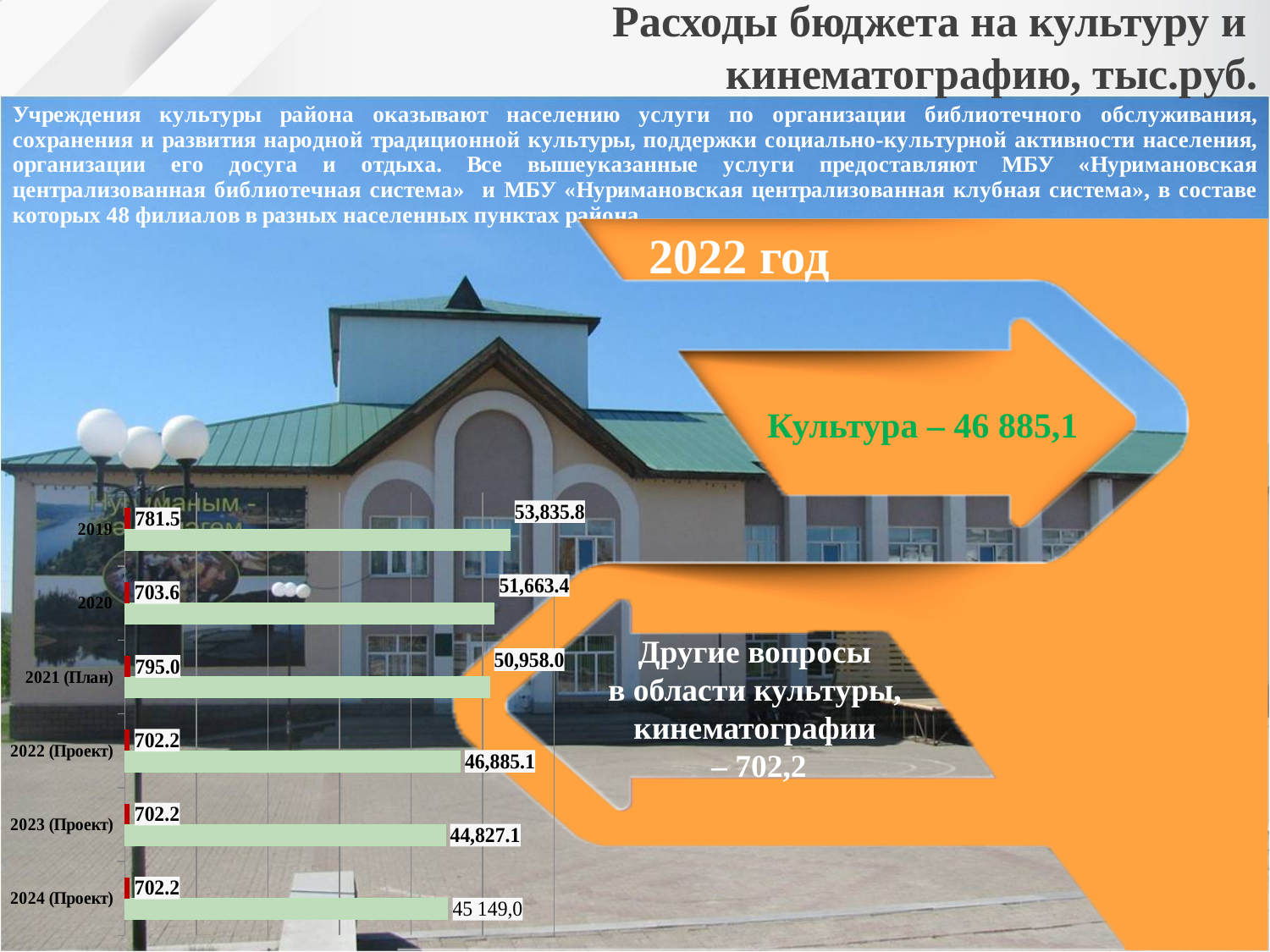
What is the value of the green bar for 2022 (Проект)? 46,885.1 What is the value of the red bar for 2020? 703.6 What is the difference between the green bar values for 2019 and 2020? 2,172.4 How many categories (years) are shown on the chart? 6 What is the value of the green bar for 2024 (Проект)? 45 149,0 What is the value of the red bar for 2021 (План)? 795.0 Which is larger: the green bar for 2021 (План) or the green bar for 2022 (Проект)? 2021 (План) Do the green bar values rise or fall from 2019 to 2023 (Проект)? fall Which category has the highest value for the green bars? 2019 Which category has the lowest value for the green bars? 2023 (Проект) What is the value of the green bar for 2019? 53,835.8 What type of chart is shown on the slide? bar chart